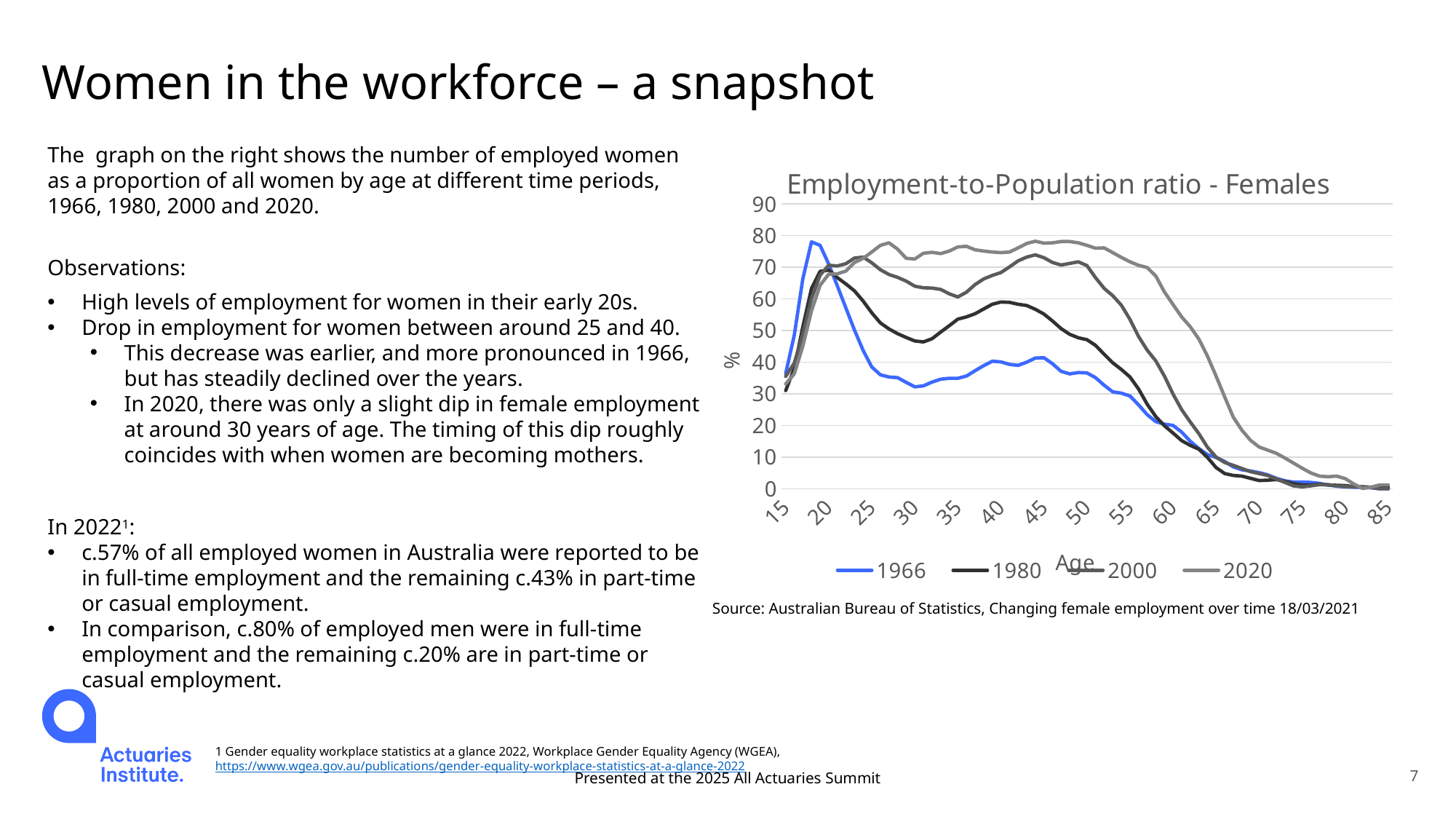
Is the value for the 1966 series at age 30 greater or less than 40? less At age 45, which series has the larger value, 1966 or 2020? 2020 How many series does the legend of the chart list? 4 Is the value for the 1966 series at age 60 greater or less than 30? less What label is shown on the x axis of the chart? Age Do the values for the 1966 series rise or fall from age 45 to age 85? fall Is the value for the 2020 series at age 45 greater or less than 70? greater Which series has the highest value at age 50? 2020 What kind of chart is shown on the slide? line chart What is the title of the chart? Employment-to-Population ratio - Females